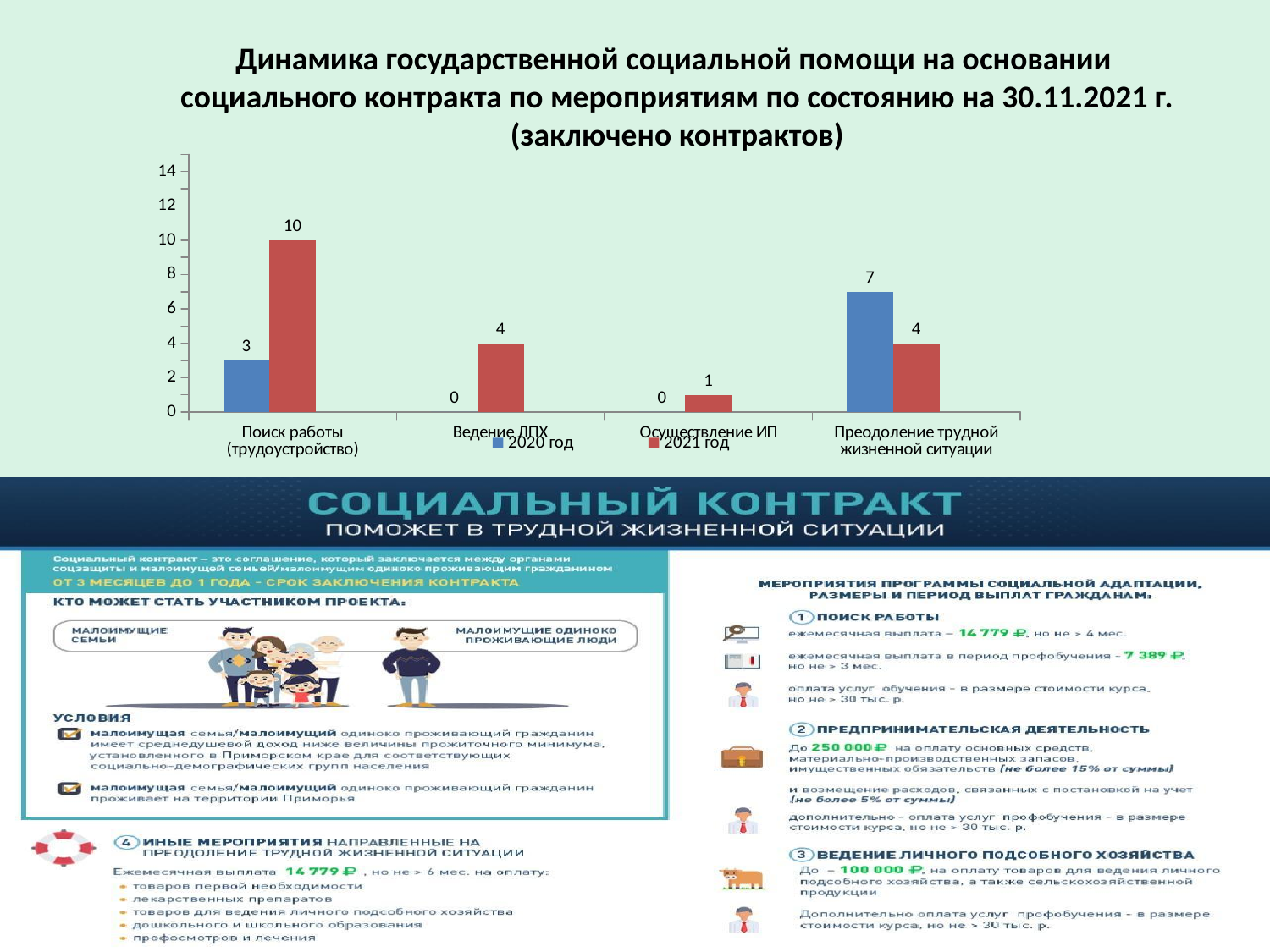
Which category has the highest value for 2020 год? Преодоление трудной жизненной ситуации How many series does the chart legend list? 2 How many categories are shown on the x axis of the chart? 4 What is the difference between the 2021 год and 2020 год values in the Поиск работы (трудоустройство) category? 7 Which category has the lowest value for 2021 год? Осуществление ИП What is the value for 2021 год in the Поиск работы (трудоустройство) category? 10 Which category has the highest value for 2021 год? Поиск работы (трудоустройство) What is the value for 2020 год in the Преодоление трудной жизненной ситуации category? 7 What is the value for 2020 год in the Осуществление ИП category? 0 In the Преодоление трудной жизненной ситуации category, which series has the larger value, 2020 год or 2021 год? 2020 год What is the value for 2021 год in the Ведение ЛПХ category? 4 What kind of chart is shown on the slide? bar chart